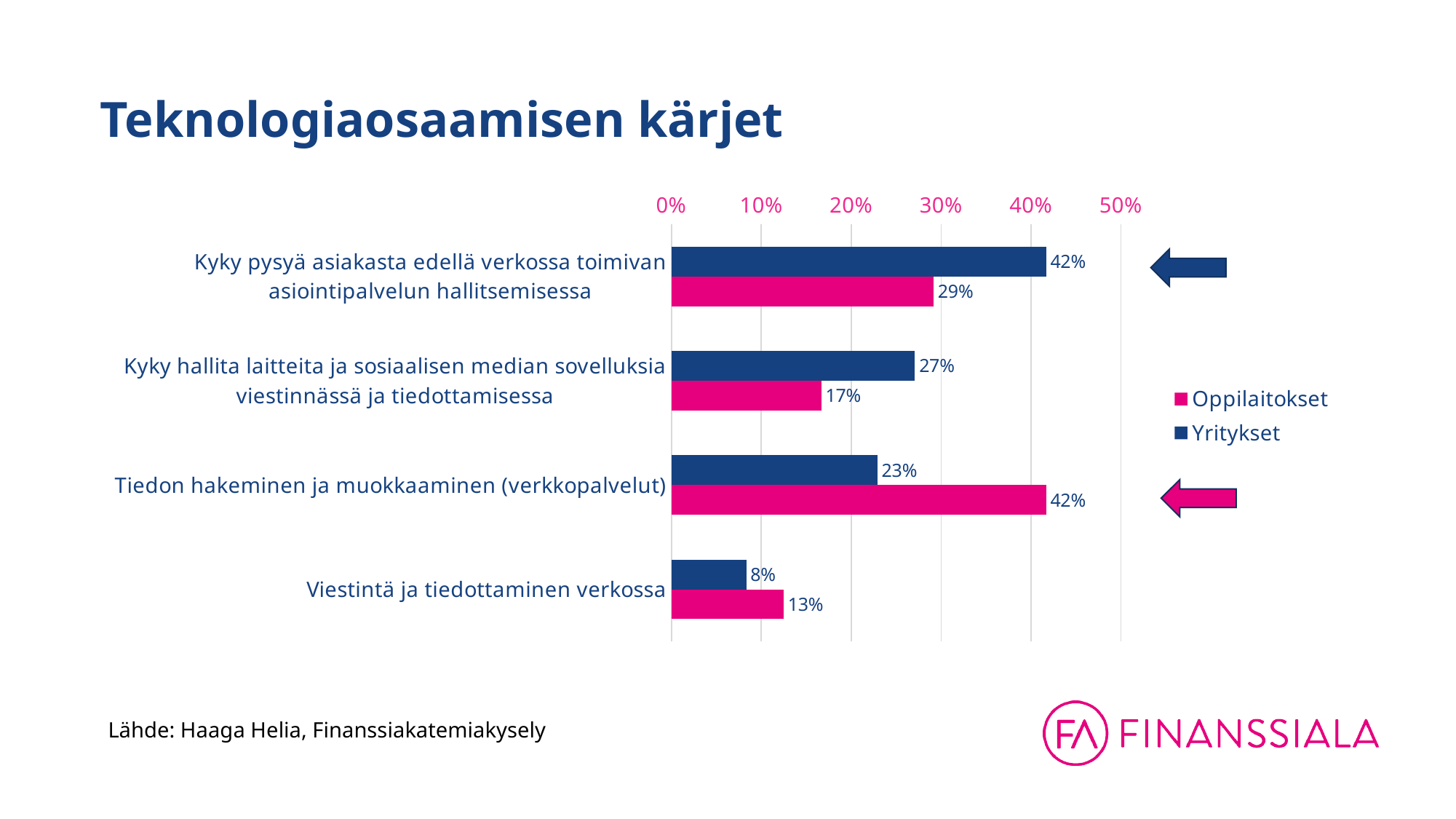
What is the difference between the Yritykset and Oppilaitokset values for "Kyky pysyä asiakasta edellä verkossa toimivan asiointipalvelun hallitsemisessa"? 13% What kind of chart is shown on the slide? Bar chart How many series does the legend list? 2 What is the Yritykset value for "Kyky pysyä asiakasta edellä verkossa toimivan asiointipalvelun hallitsemisessa"? 42% What is the Oppilaitokset value for "Tiedon hakeminen ja muokkaaminen (verkkopalvelut)"? 42% What is the Yritykset value for "Viestintä ja tiedottaminen verkossa"? 8% Is the Oppilaitokset value for "Viestintä ja tiedottaminen verkossa" greater or less than 20%? less Which category has the lowest Yritykset value? Viestintä ja tiedottaminen verkossa Which category has the highest Oppilaitokset value? Tiedon hakeminen ja muokkaaminen (verkkopalvelut) How many categories are shown in the chart? 4 What is the Oppilaitokset value for "Kyky hallita laitteita ja sosiaalisen median sovelluksia viestinnässä ja tiedottamisessa"? 17% For "Tiedon hakeminen ja muokkaaminen (verkkopalvelut)", which series has the larger value, Oppilaitokset or Yritykset? Oppilaitokset